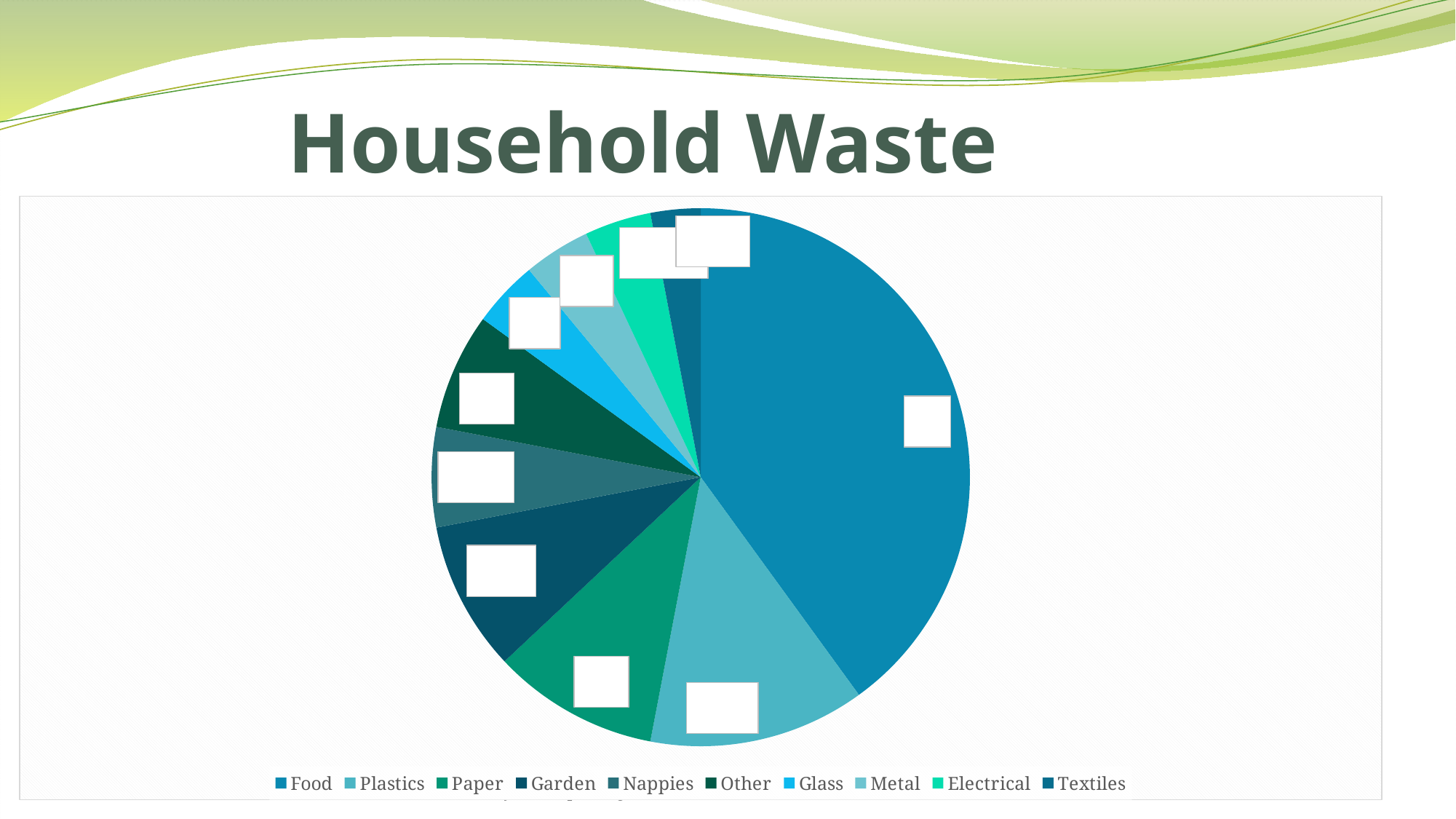
What is the title of the slide containing the pie chart? Household Waste What kind of chart is shown on the slide? pie chart Which slice is larger, Garden or Nappies? Garden Which slice is larger, Plastics or Paper? Plastics Which slice is larger, Other or Glass? Other Which category is listed first in the legend of the pie chart? Food Which category has the largest slice of the pie chart? Food How many categories does the legend of the pie chart list? 10